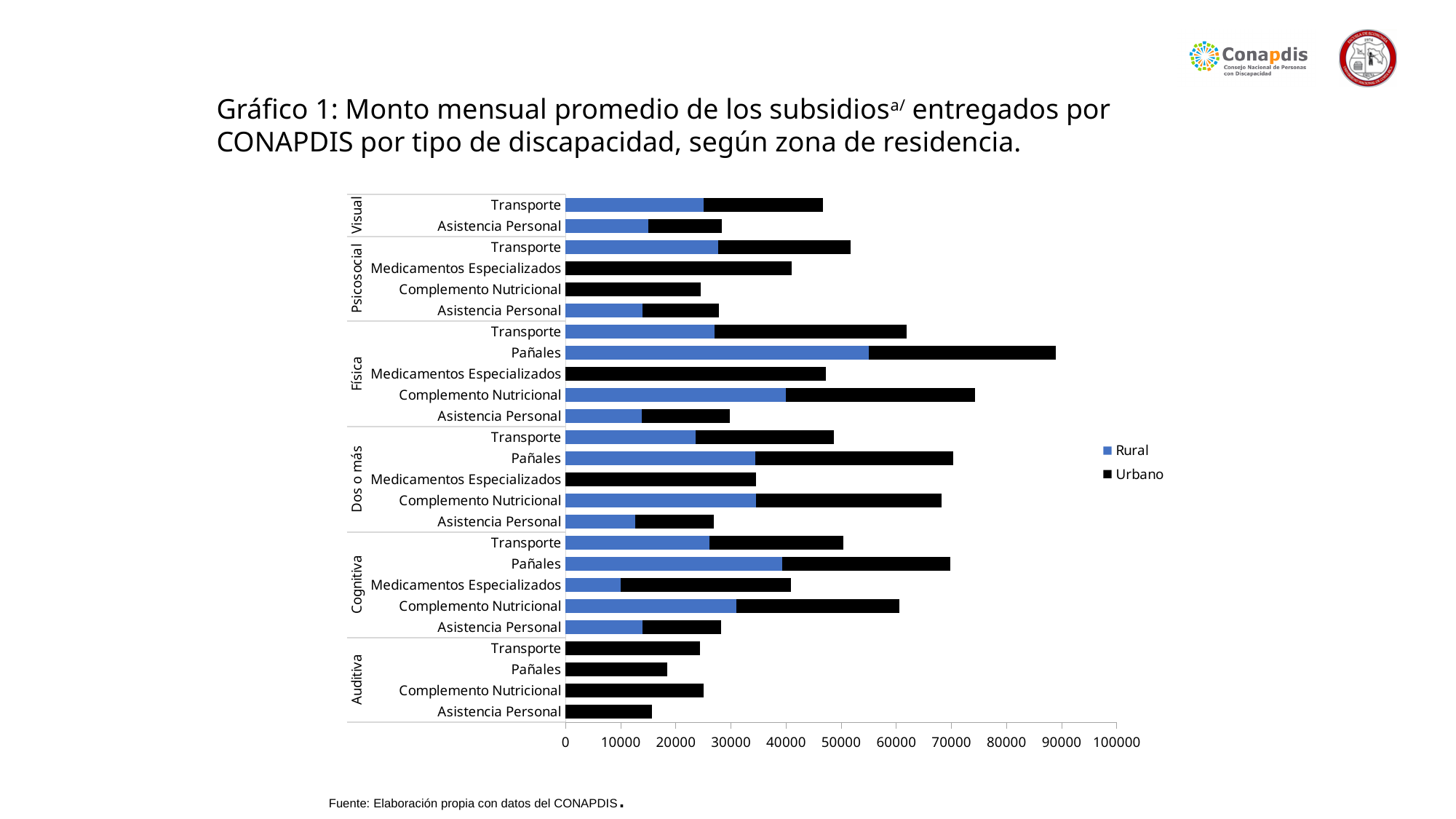
Which has a larger total: Transporte in the Física group or Transporte in the Cognitiva group? Transporte in the Física group Is the Rural value for Pañales in the Física group greater or less than 50000? greater Is the total value for Pañales in the Física group greater or less than 80000? greater Which disability group shows no Rural (blue) segment in any of its bars? Auditiva What kind of chart is shown on the slide? Stacked bar chart Is the total value for Complemento Nutricional in the Física group greater or less than 70000? greater Which two series are listed in the legend? Rural and Urbano How many series does the legend list? 2 Which bar has the lowest total monthly amount? Asistencia Personal (Auditiva) How many bars (subsidy categories) are plotted in the chart? 25 Which bar has the highest total monthly amount? Pañales (Física)